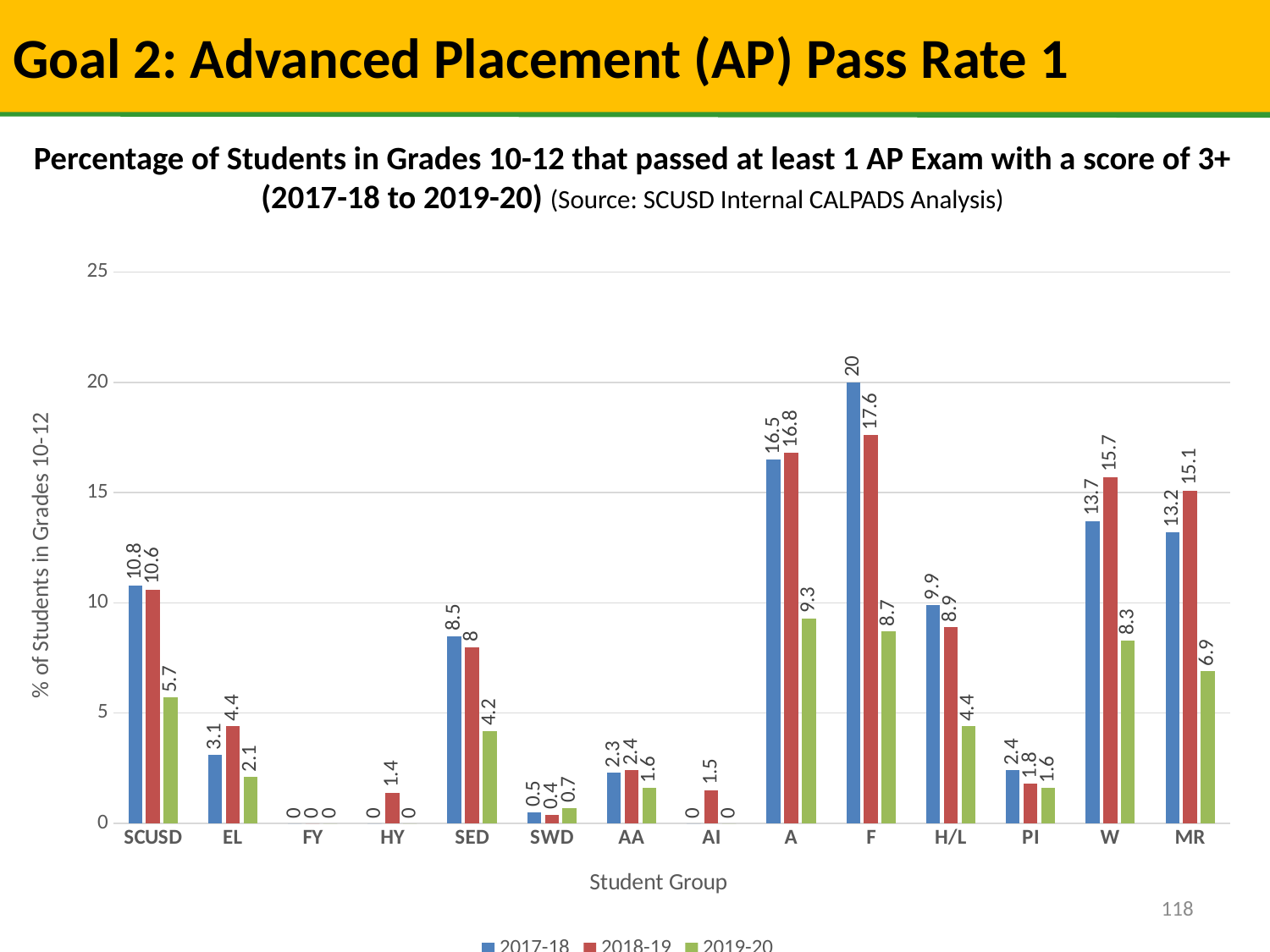
How many student groups are shown on the x axis? 14 What is the label of the y axis? % of Students in Grades 10-12 Which student group has the highest 2017-18 value? F Which is larger for the MR student group, the 2017-18 value or the 2018-19 value? 2018-19 What kind of chart is shown on the slide? Bar chart What is the 2019-20 value for SCUSD? 5.7 What is the 2017-18 value for the F student group? 20 What is the 2018-19 value for the W student group? 15.7 Is the 2018-19 value for the F student group greater or less than 15? greater What is the difference between the 2018-19 and 2019-20 values for the A student group? 7.5 How many series does the legend list? 3 Which student group has the highest 2019-20 value? A